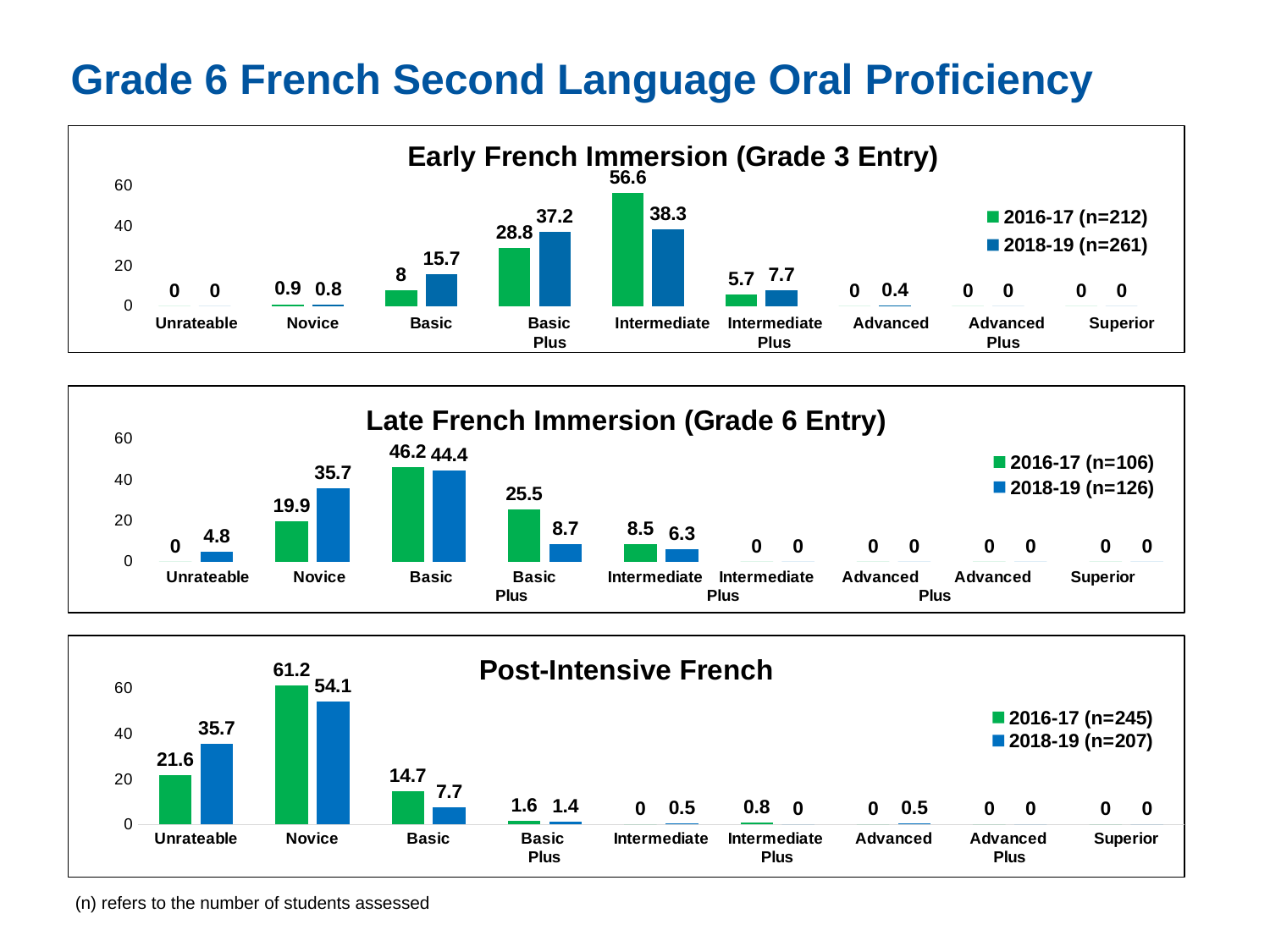
In the Post-Intensive French chart, is the 2016-17 value for Novice greater or less than 60? greater In the Early French Immersion (Grade 3 Entry) chart, what is the value for Intermediate in 2016-17 (n=212)? 56.6 In the Early French Immersion (Grade 3 Entry) chart, which category has the highest value for 2018-19 (n=261)? Intermediate In the Late French Immersion (Grade 6 Entry) chart, what is the value for Novice in 2018-19 (n=126)? 35.7 How many series does the legend of the Late French Immersion (Grade 6 Entry) chart list? 2 In the Early French Immersion (Grade 3 Entry) chart, what is the difference between the 2016-17 and 2018-19 values for Basic? 7.7 In the Late French Immersion (Grade 6 Entry) chart, which category has the highest value for 2016-17 (n=106)? Basic In the Post-Intensive French chart, what is the difference between the 2016-17 and 2018-19 values for Novice? 7.1 In the Post-Intensive French chart, what is the value for Unrateable in 2016-17 (n=245)? 21.6 How many categories are shown on the x axis of the Post-Intensive French chart? 9 In the Early French Immersion (Grade 3 Entry) chart, what is the value for Basic Plus in 2018-19 (n=261)? 37.2 In the Late French Immersion (Grade 6 Entry) chart, which is larger for Basic Plus: the 2016-17 value or the 2018-19 value? 2016-17